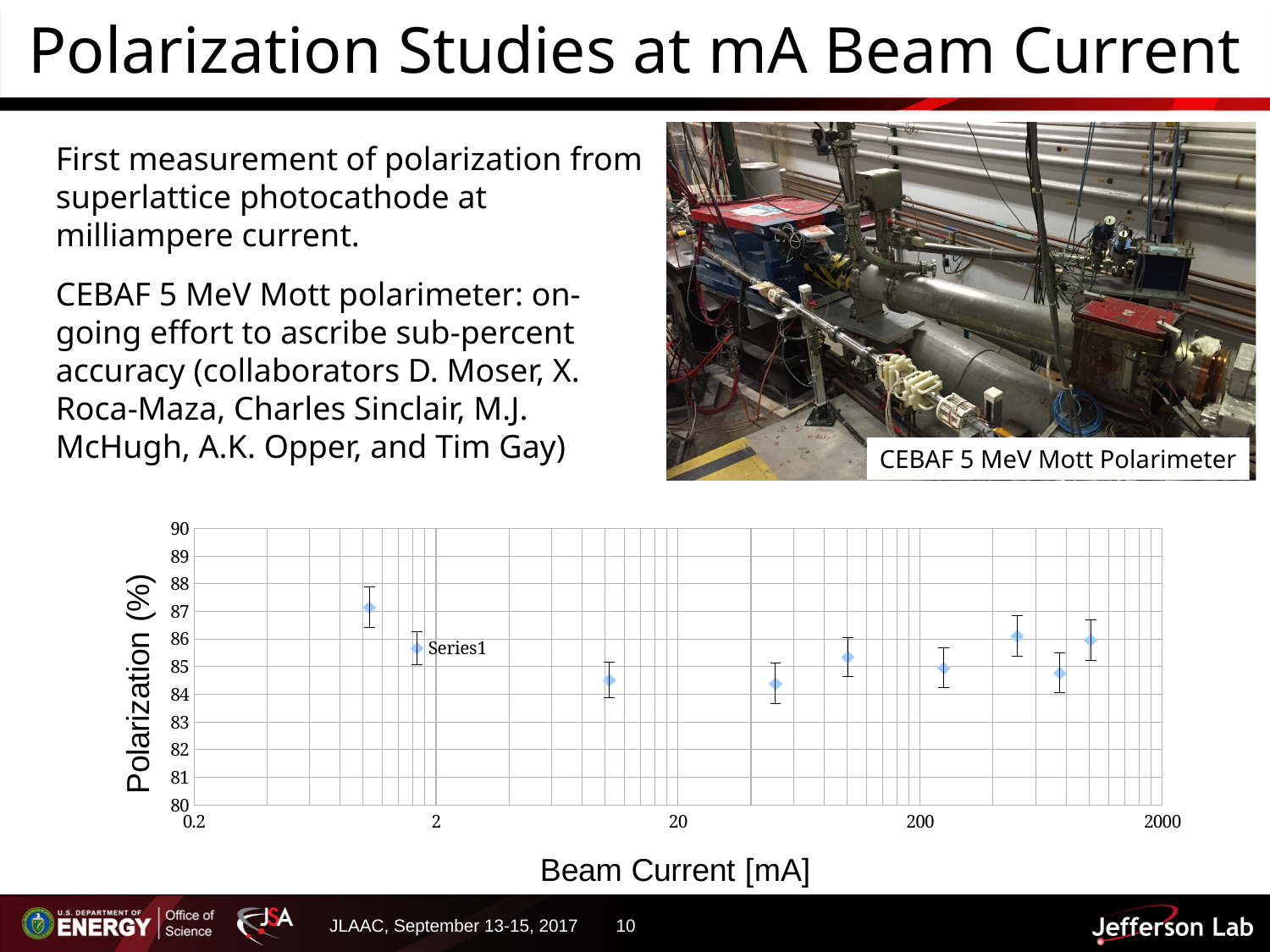
What is the title of the x axis of the chart? Beam Current [mA] What is the label of the series shown in the chart? Series1 How many series does the chart show? 1 Which data point has the highest polarization value? The leftmost data point How many data points are plotted in the chart? 9 Which has the higher polarization: the first data point or the second data point from the left? The first data point Is the polarization value of the data point near 500 mA greater or less than 85? greater Is the polarization value of the data point near 50 mA greater or less than 85? less What is the maximum value shown on the y axis of the chart? 90 What kind of chart is shown on the slide? Scatter chart Is the polarization value of the leftmost data point greater or less than 86? greater